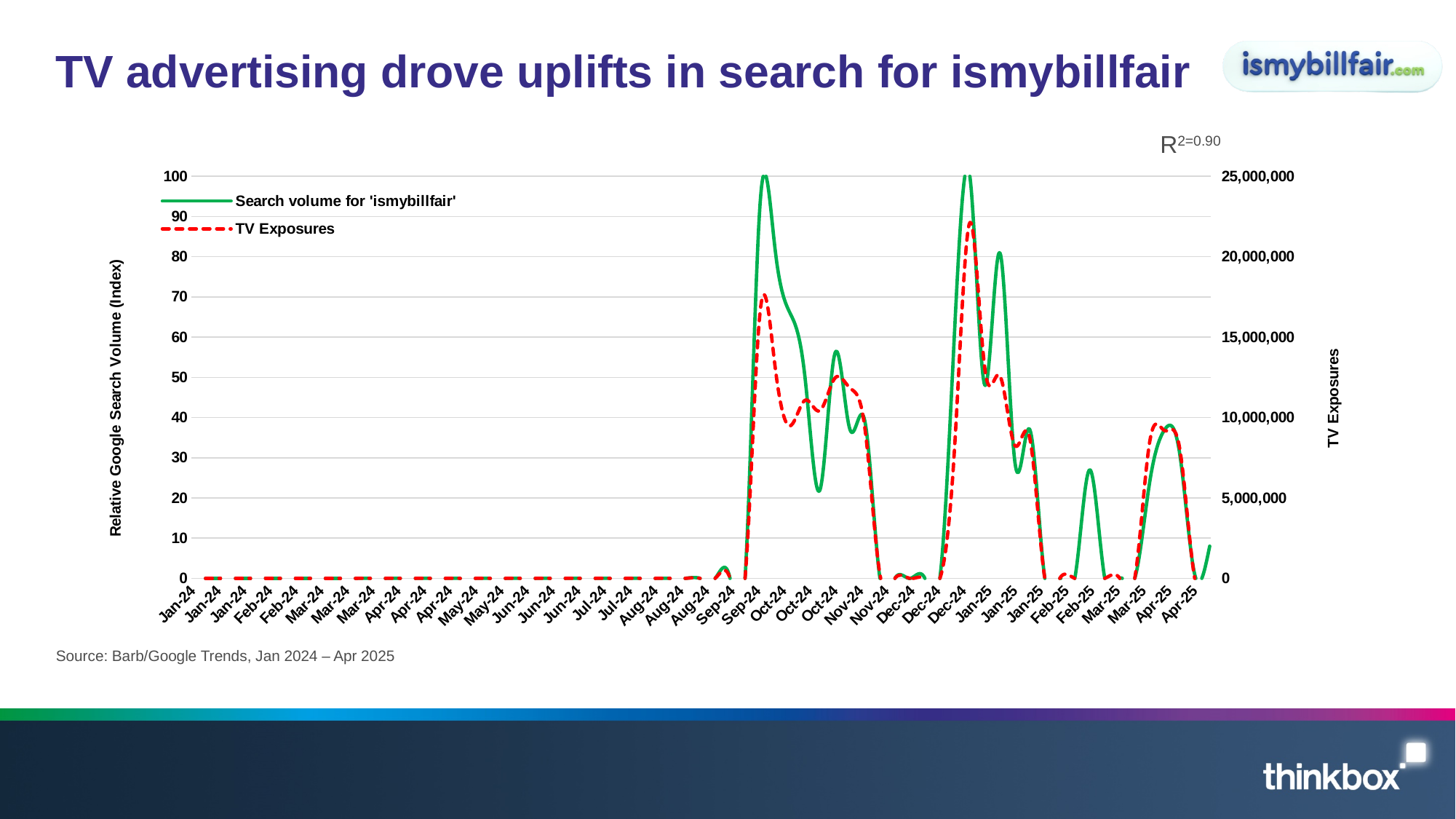
Is the second-highest peak of the search volume line, around Jan-25, greater or less than 70? greater What is the value of the search volume for 'ismybillfair' line at Jan-24? 0 Is the highest peak of the TV Exposures line, around Dec-24, greater or less than 20,000,000? greater How many series does the chart's legend list? 2 Which series is drawn as a red dashed line? TV Exposures What kind of chart is shown on the slide? line chart What are the two series named in the legend? Search volume for 'ismybillfair' and TV Exposures Does the search volume for 'ismybillfair' line rise, fall, or stay flat between Jan-24 and Aug-24? stay flat Is the peak of the search volume line in Feb-25 greater or less than 20? greater What is the highest value reached by the search volume for 'ismybillfair' line on the left axis? 100 What R-squared value is shown above the chart? 0.90